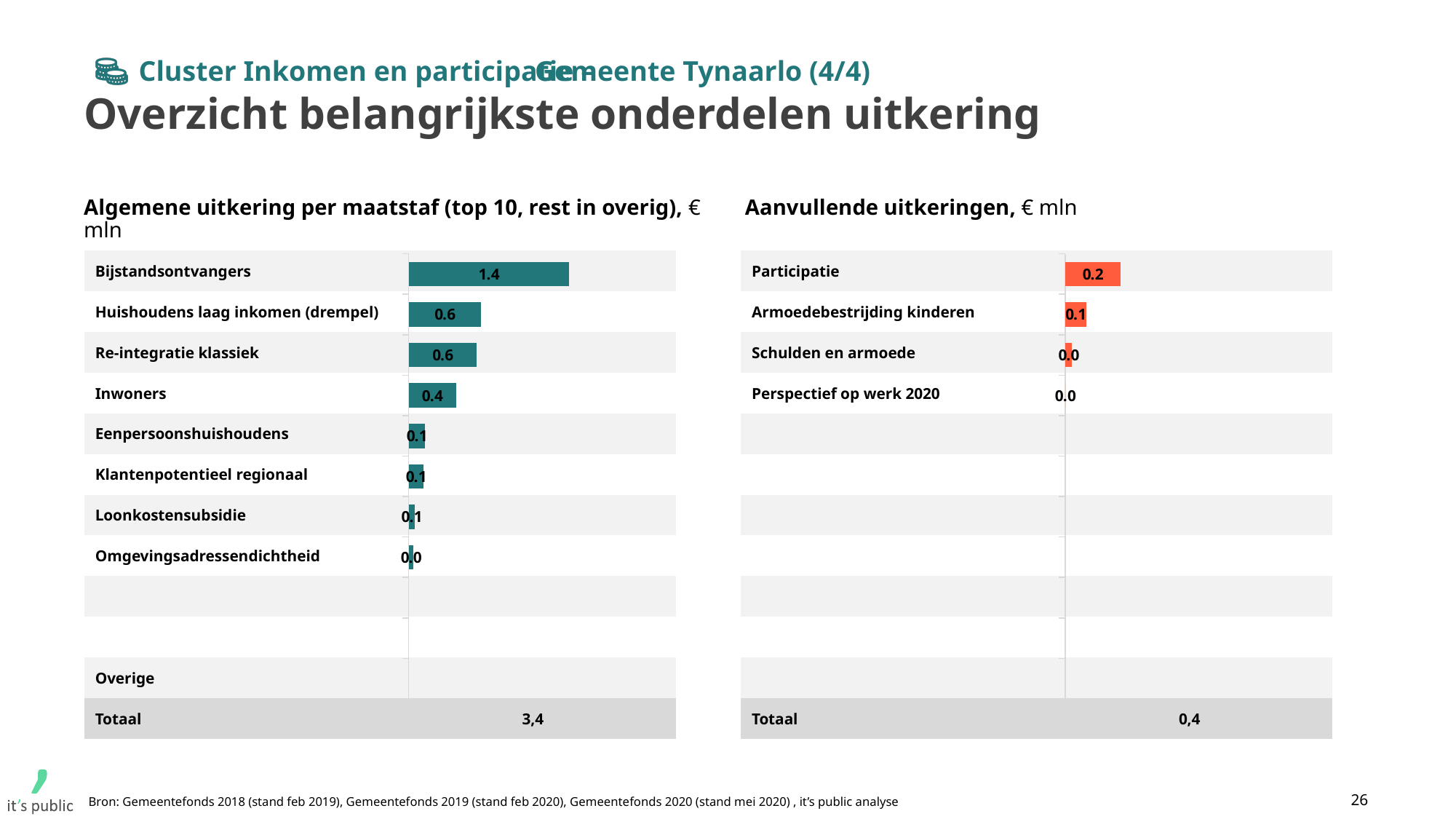
In the chart 'Aanvullende uitkeringen', which category has the highest value? Participatie What is the Totaal shown at the bottom of the chart 'Algemene uitkering per maatstaf'? 3,4 In the chart 'Algemene uitkering per maatstaf', what is the value for Bijstandsontvangers? 1.4 What kind of chart is 'Aanvullende uitkeringen'? Bar chart In the chart 'Aanvullende uitkeringen', what is the value for Armoedebestrijding kinderen? 0.1 In the chart 'Algemene uitkering per maatstaf', what is the difference between Bijstandsontvangers and Inwoners? 1.0 In the chart 'Aanvullende uitkeringen', which is larger: Participatie or Armoedebestrijding kinderen? Participatie In the chart 'Aanvullende uitkeringen', what is the value for Participatie? 0.2 In the chart 'Algemene uitkering per maatstaf', which category has the highest value? Bijstandsontvangers In the chart 'Aanvullende uitkeringen', how many categories are shown? 4 In the chart 'Algemene uitkering per maatstaf', which category has the lowest value? Omgevingsadressendichtheid In the chart 'Algemene uitkering per maatstaf', what is the value for Inwoners? 0.4